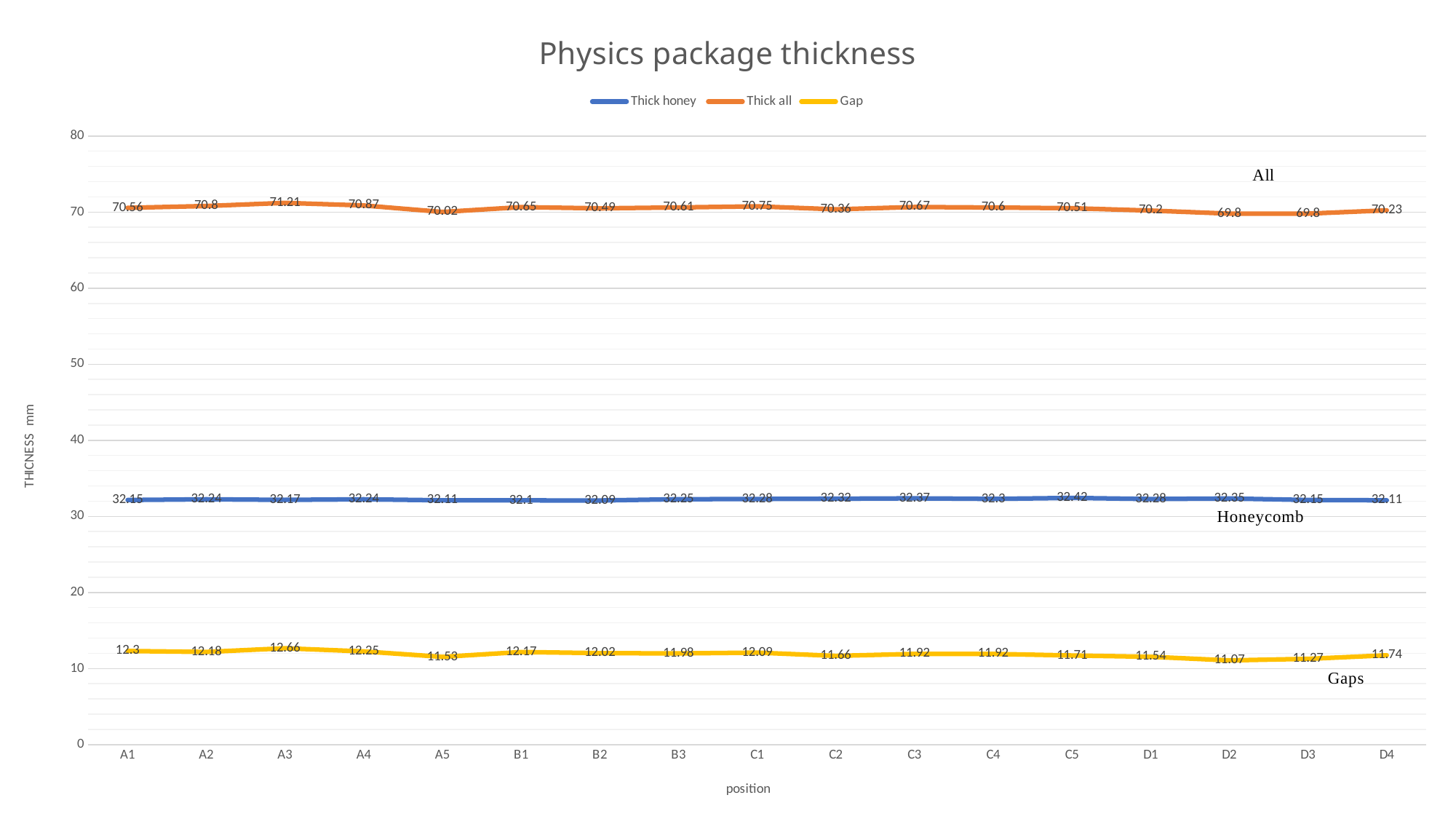
At which position is Thick all highest? A3 What is the value of Thick honey at position C5? 32.42 What is the title of the chart? Physics package thickness What is the difference between Thick all and Thick honey at position A1? 38.41 How many series does the legend list? 3 What is the value of Gap at position D2? 11.07 What type of chart is shown on the slide? line chart At which position is Gap lowest? D2 How many positions are plotted along the x axis? 17 What is the value of Thick all at position A3? 71.21 Which is larger at position B1: Thick honey or Gap? Thick honey Is the value for Thick all at position D2 greater or less than 60? greater